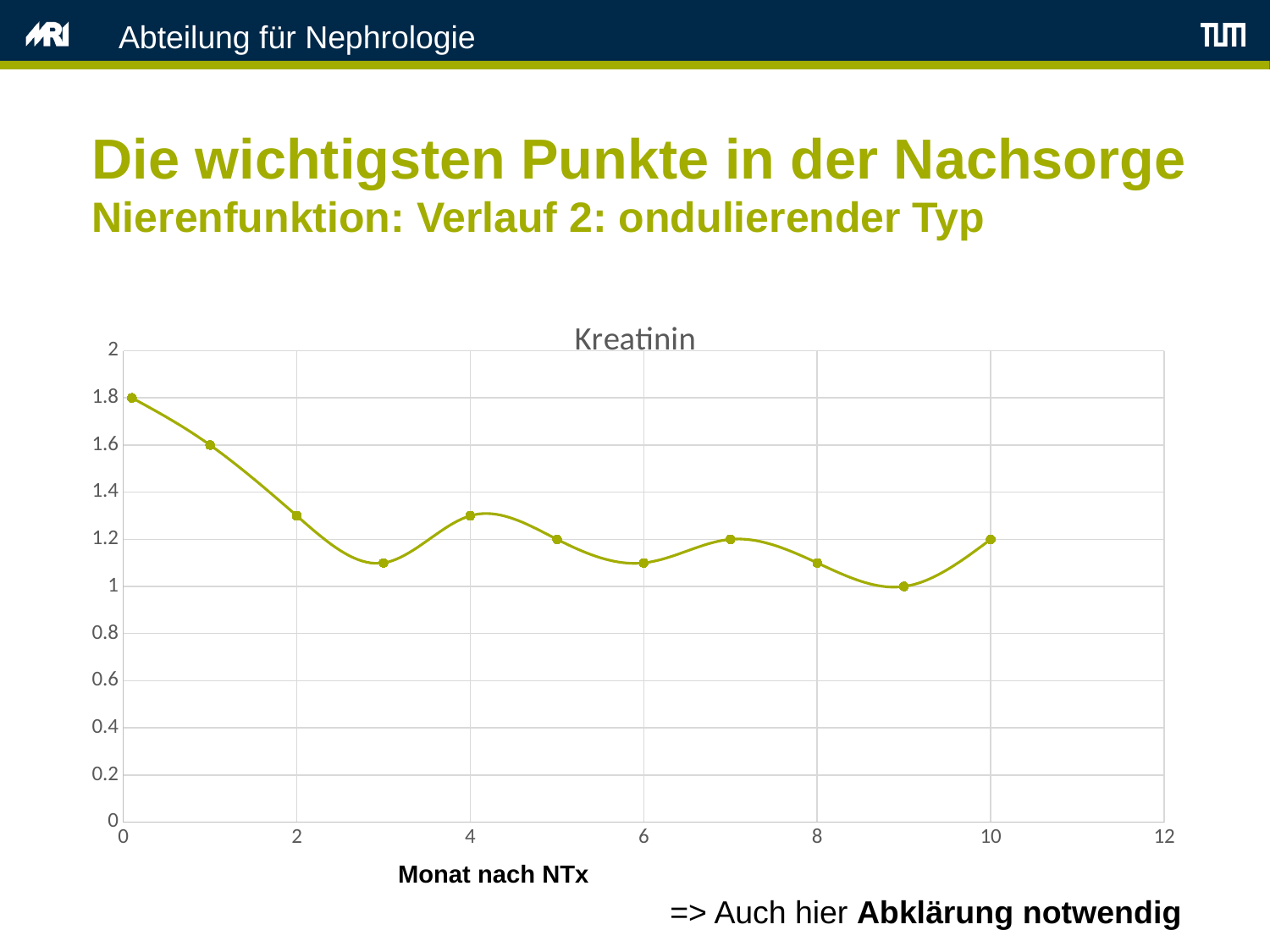
At which month is the Kreatinin value highest? 0 What is the Kreatinin value at month 1? 1.6 What is the label of the x axis? Monat nach NTx At which month is the Kreatinin value lowest? 9 What is the Kreatinin value at month 10? 1.2 What is the Kreatinin value at month 9? 1 Is the Kreatinin value at month 2 greater or less than 1.4? less How many data points are plotted on the chart? 11 What is the title of the chart? Kreatinin What is the difference between the Kreatinin values at month 0 and month 10? 0.6 What is the Kreatinin value at month 0? 1.8 What kind of chart is shown on the slide? line chart